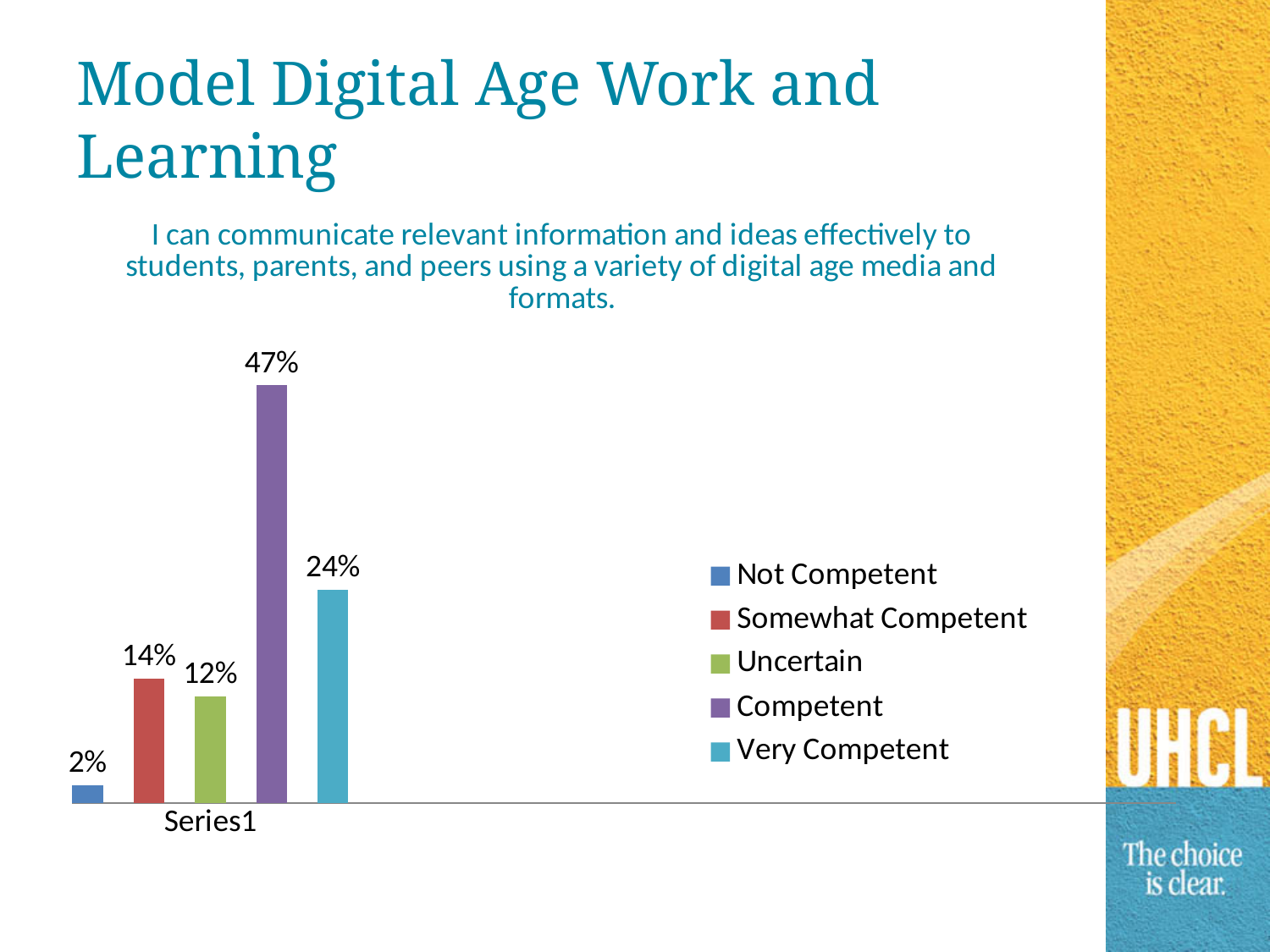
What is the value for Very Competent? 24% What is the difference between the Competent and Very Competent values? 23% Which category has the highest value? Competent What is the value for Not Competent? 2% Which category has the lowest value? Not Competent What is the difference between the Somewhat Competent and Not Competent values? 12% How many series does the legend list? 5 What percentage of respondents rated themselves Competent? 47% What is the value for Uncertain? 12% What kind of chart is shown on the slide? Bar chart Which is larger, Somewhat Competent or Uncertain? Somewhat Competent What colour is the bar for Competent? Purple